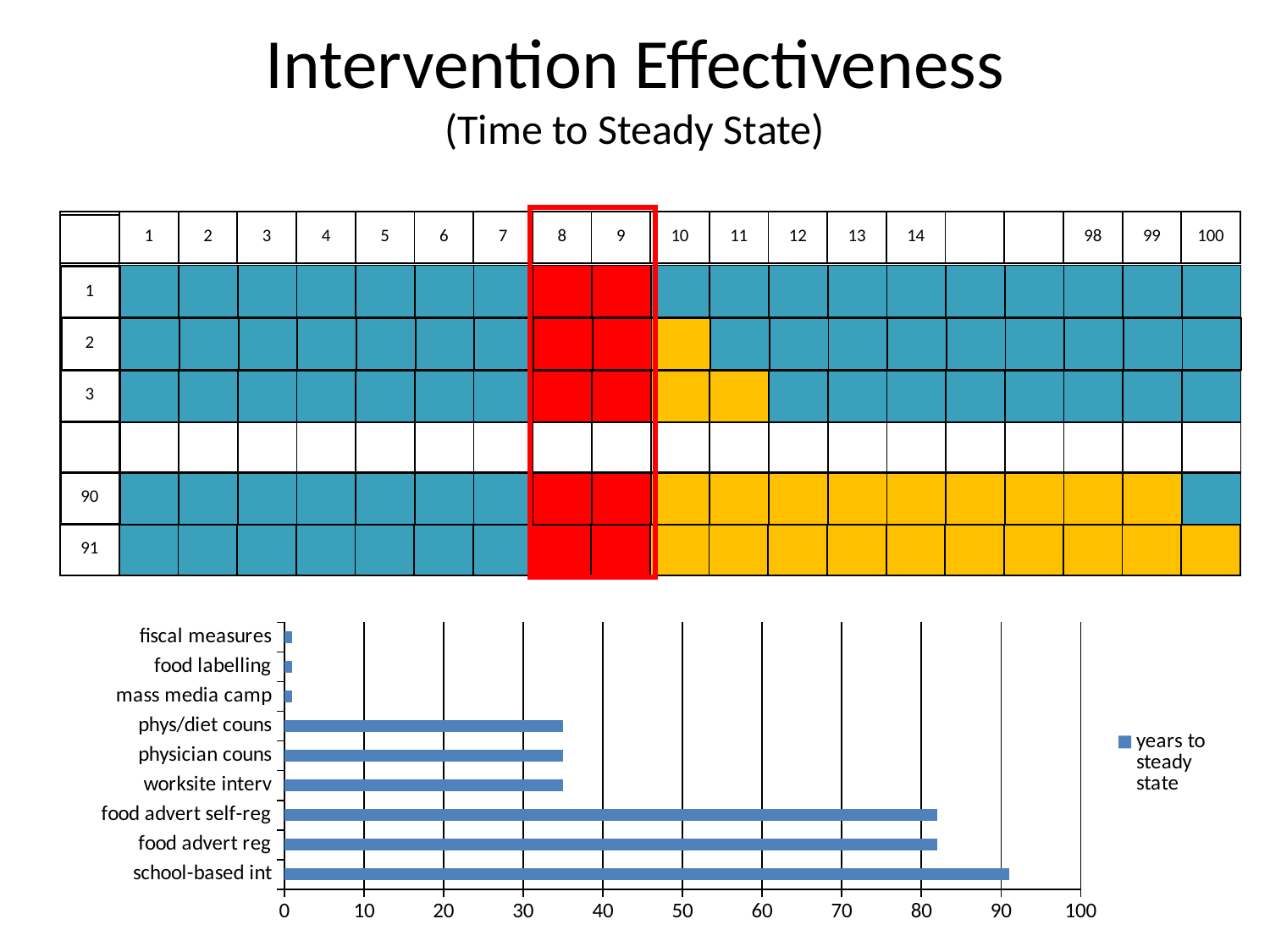
How many categories does the bar chart show? 9 Is the value for school-based int greater or less than 80? greater What is the legend entry for the series in the bar chart? years to steady state Which is larger, the value for worksite interv or the value for food labelling? worksite interv Is the value for fiscal measures greater or less than 10? less Which category has the highest value in the bar chart? school-based int Is the value for food advert reg greater or less than 90? less Which is larger, the value for school-based int or the value for food advert reg? school-based int What kind of chart is shown at the bottom of the slide? bar chart How many series does the bar chart's legend list? 1